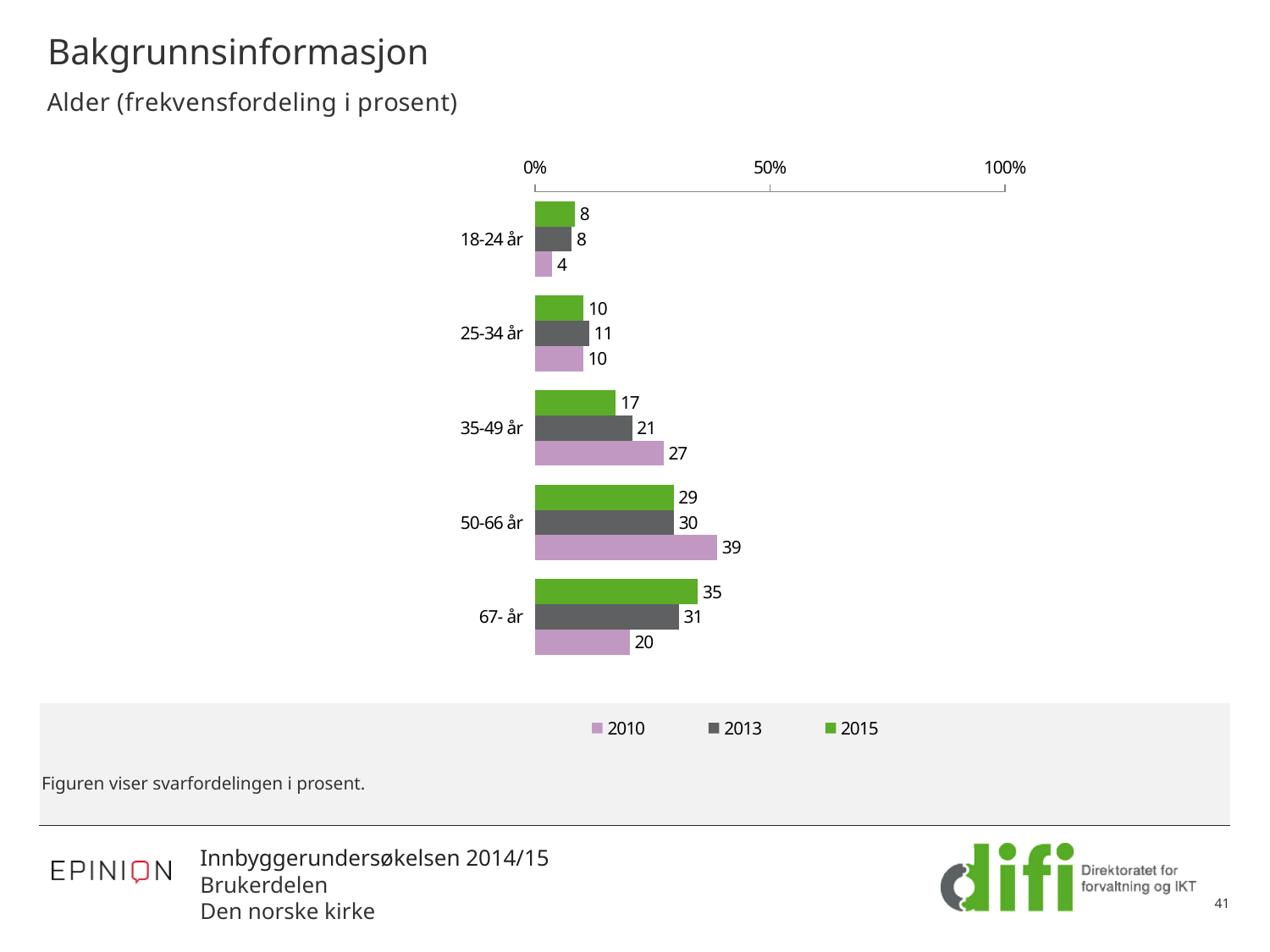
What is the value for 35-49 år in 2013? 21 Is the value for 50-66 år in 2010 greater or less than 50%? less Which age category has the lowest value for 2015? 18-24 år What is the value for 50-66 år in 2010? 39 Which age category has the highest value for 2010? 50-66 år How many age categories are shown on the chart? 5 What is the difference between the 2010 and 2015 values for 67- år? 15 Which is larger for 35-49 år: the 2010 value or the 2015 value? 2010 What kind of chart is shown on the slide? bar chart How many series does the legend list? 3 Which colour represents the 2013 series in the legend? grey What is the value for 67- år in 2015? 35